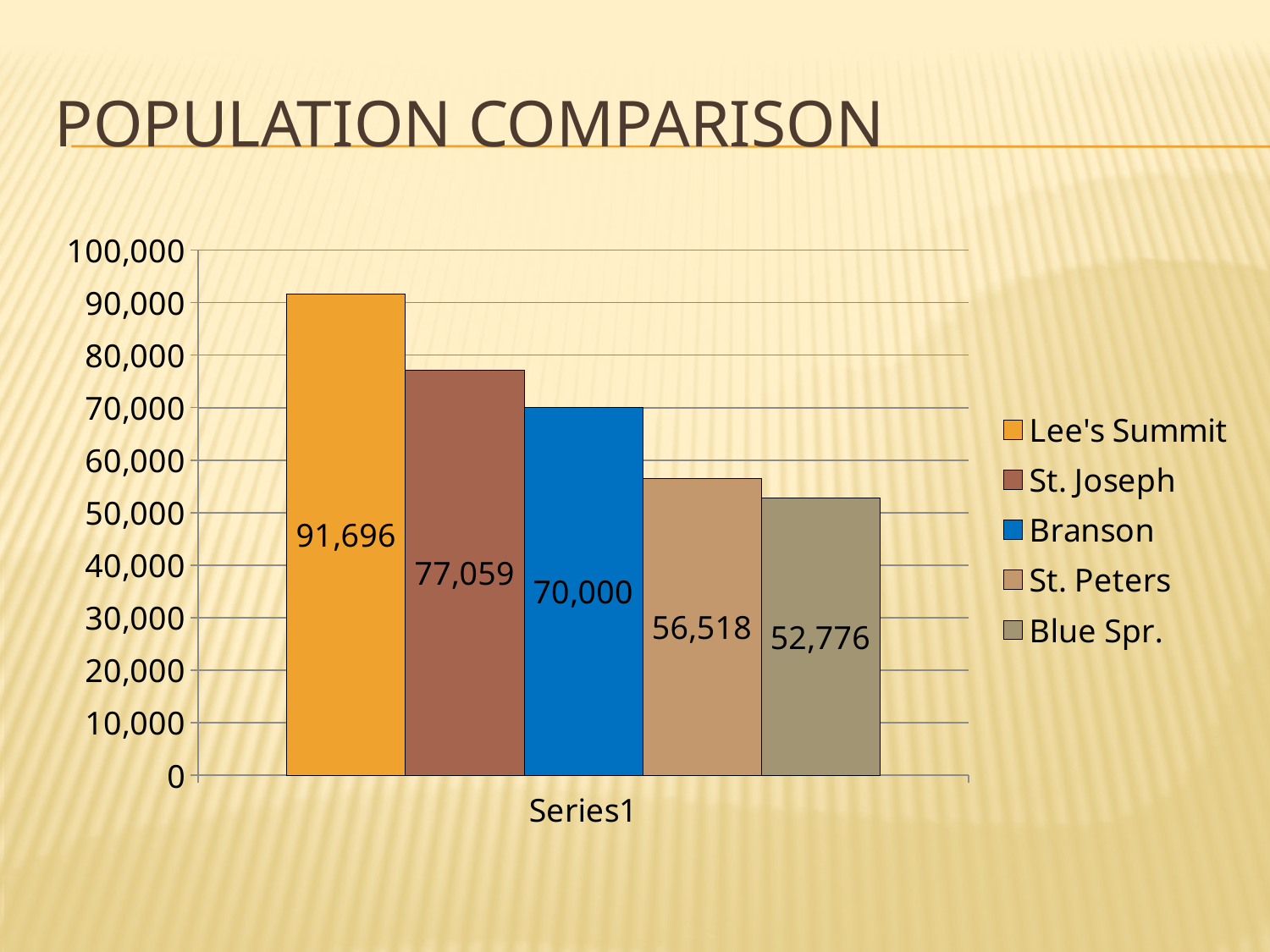
What is the population value shown for Blue Spr.? 52,776 What is the title of the slide? POPULATION COMPARISON What is the difference between the populations of St. Peters and Blue Spr.? 3,742 Which city has the highest population in the chart? Lee's Summit How many cities are shown in the chart? 5 Which city has the lowest population in the chart? Blue Spr. What is the population value shown for Branson? 70,000 What is the population value shown for St. Joseph? 77,059 Which has a larger population, Branson or St. Peters? Branson What kind of chart is shown on the slide? Bar chart What is the population value shown for Lee's Summit? 91,696 What is the difference between the populations of Lee's Summit and St. Joseph? 14,637